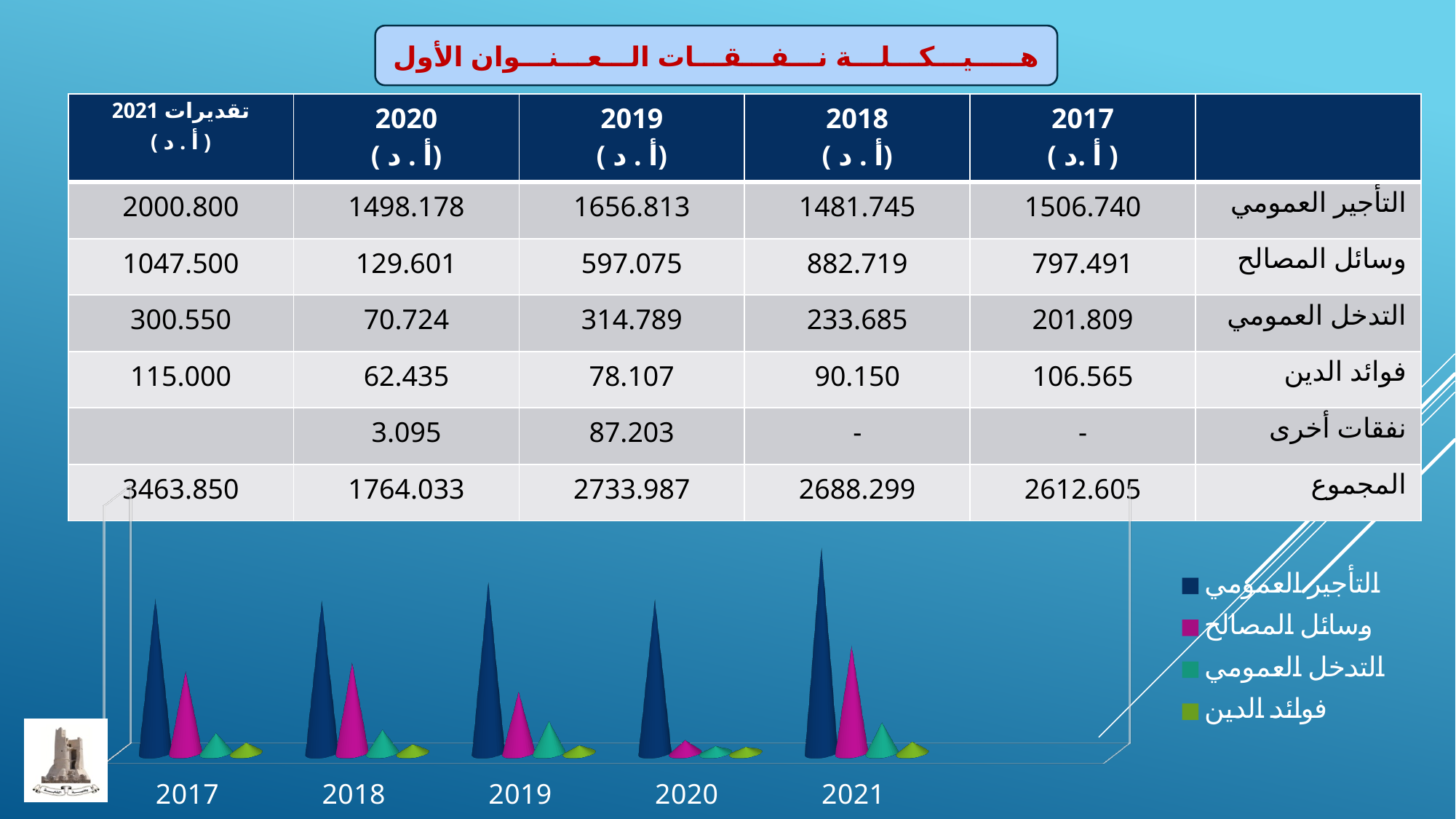
In which year is the وسائل المصالح bar the shortest? 2020 In which year is the التأجير العمومي bar the tallest? 2021 How many series does the chart legend list? 4 Which series is shown in magenta in the chart legend? وسائل المصالح What kind of chart is shown at the bottom of the slide? bar chart According to the table on the slide, what is the value of التأجير العمومي for 2017? 1506.740 Does the التأجير العمومي bar rise or fall from 2020 to 2021? rise Which is larger in the chart, وسائل المصالح in 2021 or in 2019? 2021 Which is larger in the chart, التأجير العمومي in 2019 or in 2018? 2019 How many years are shown along the x axis of the chart? 5 According to the table on the slide, what is the value of فوائد الدين for 2020? 62.435 Which series is shown in dark blue in the chart legend? التأجير العمومي